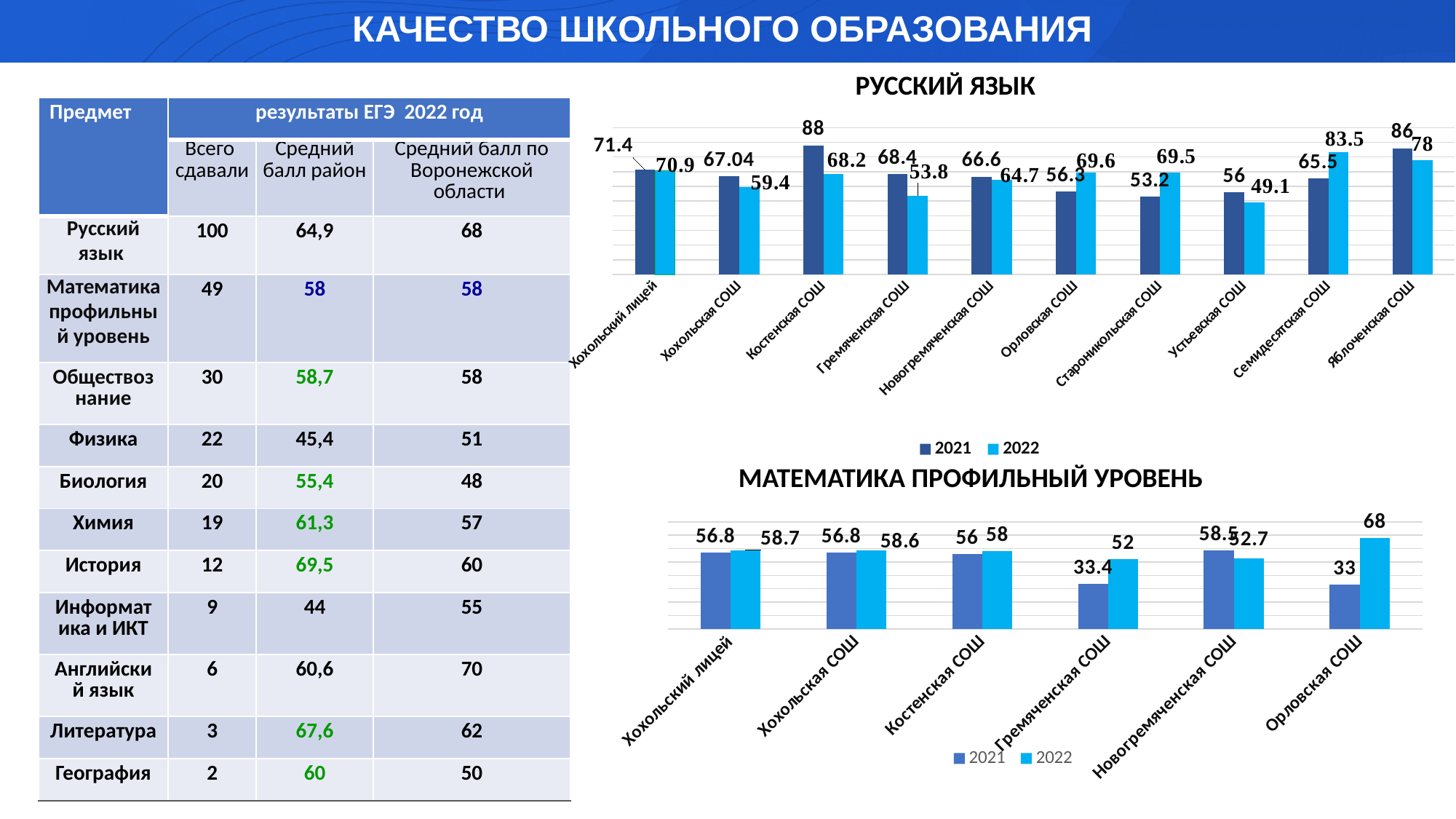
In the РУССКИЙ ЯЗЫК chart, is the 2022 value for Орловская СОШ larger than its 2021 value? Yes In the РУССКИЙ ЯЗЫК chart, what is the 2022 value for Семидесятская СОШ? 83.5 In the РУССКИЙ ЯЗЫК chart, what is the difference between the 2021 and 2022 values for Костенская СОШ? 19.8 In the РУССКИЙ ЯЗЫК chart, what is the 2021 value for Костенская СОШ? 88 In the РУССКИЙ ЯЗЫК chart, which school has the highest 2021 value? Костенская СОШ In the МАТЕМАТИКА ПРОФИЛЬНЫЙ УРОВЕНЬ chart, what is the 2022 value for Орловская СОШ? 68 In the МАТЕМАТИКА ПРОФИЛЬНЫЙ УРОВЕНЬ chart, how many series does the legend list? 2 In the РУССКИЙ ЯЗЫК chart, how many schools are shown on the x axis? 10 In the МАТЕМАТИКА ПРОФИЛЬНЫЙ УРОВЕНЬ chart, which school has the lowest 2021 value? Орловская СОШ In the РУССКИЙ ЯЗЫК chart, which school has the lowest 2022 value? Устьевская СОШ In the МАТЕМАТИКА ПРОФИЛЬНЫЙ УРОВЕНЬ chart, what is the difference between the 2022 and 2021 values for Гремяченская СОШ? 18.6 What type of chart is the МАТЕМАТИКА ПРОФИЛЬНЫЙ УРОВЕНЬ chart? Bar chart